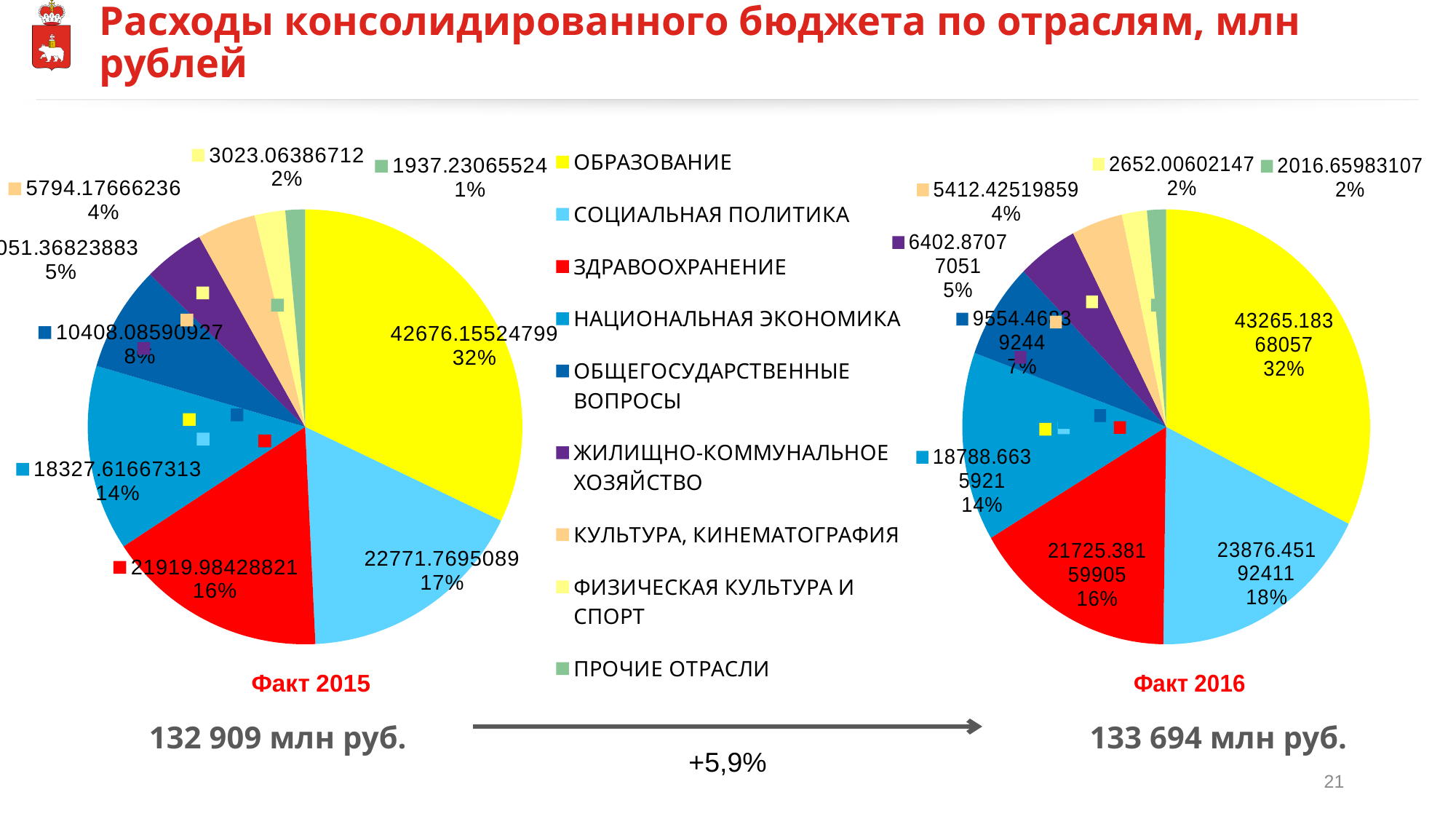
In the Факт 2015 pie chart, what value is shown for СОЦИАЛЬНАЯ ПОЛИТИКА? 22771.7695089 In the Факт 2015 pie chart, by how many percentage points does the share of ОБРАЗОВАНИЕ exceed the share of СОЦИАЛЬНАЯ ПОЛИТИКА? 15 percentage points How many categories does the legend list for the pie charts? 9 In the Факт 2016 pie chart, what share does СОЦИАЛЬНАЯ ПОЛИТИКА have? 18% In the Факт 2015 pie chart, what value is shown for ОБРАЗОВАНИЕ? 42676.15524799 What is the title of the slide? Расходы консолидированного бюджета по отраслям, млн рублей In the Факт 2015 pie chart, which category has the largest slice? ОБРАЗОВАНИЕ In the Факт 2015 pie chart, what share of the total does ОБРАЗОВАНИЕ have? 32% In the Факт 2016 pie chart, what share does ЗДРАВООХРАНЕНИЕ have? 16% In the Факт 2015 pie chart, which is larger: ЗДРАВООХРАНЕНИЕ or НАЦИОНАЛЬНАЯ ЭКОНОМИКА? ЗДРАВООХРАНЕНИЕ What type of chart is used on this slide for Факт 2015 and Факт 2016? Pie chart In the Факт 2015 pie chart, which category has the smallest slice? ПРОЧИЕ ОТРАСЛИ